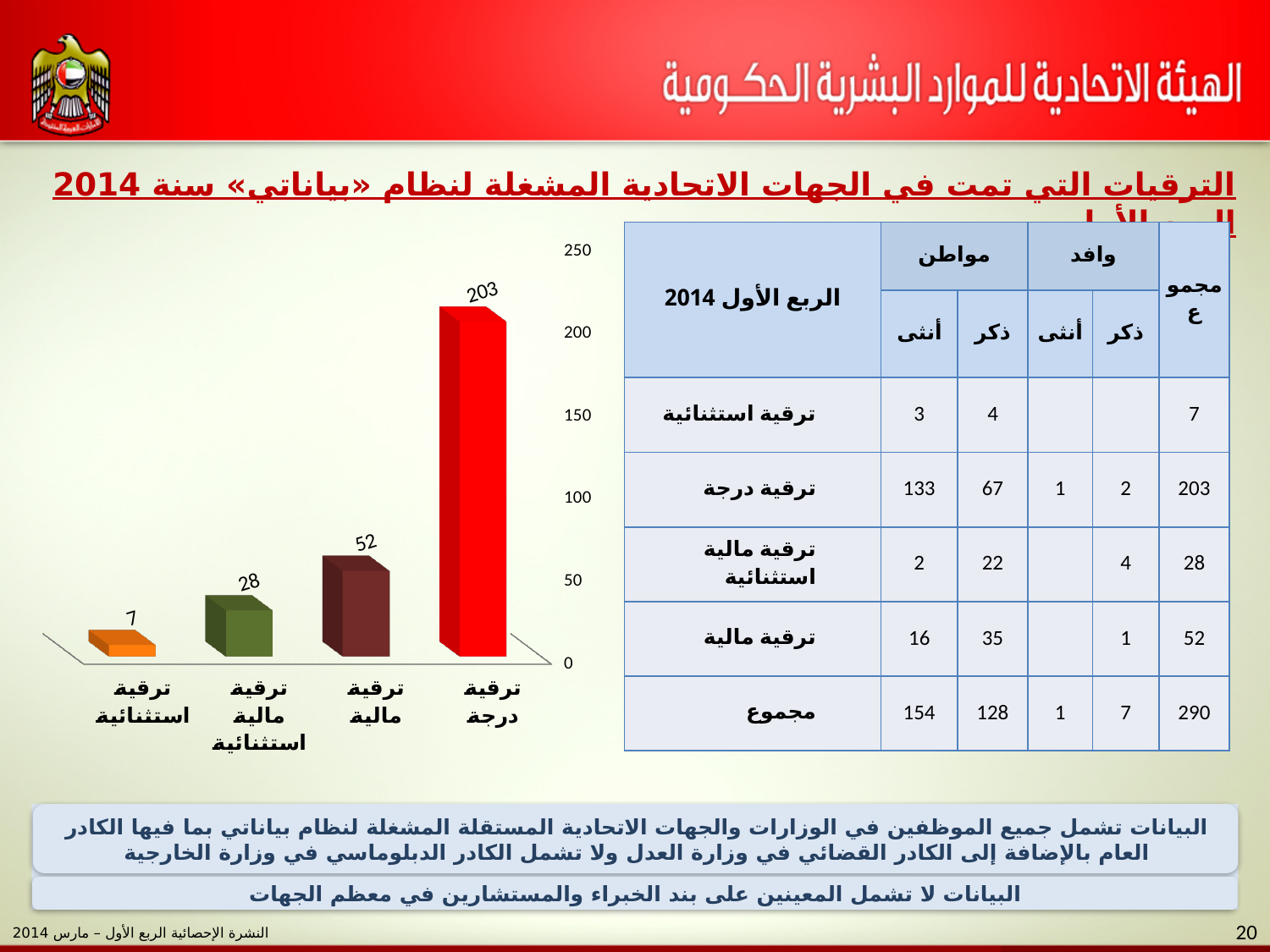
What is the difference between the values for ترقية درجة and ترقية مالية in the bar chart? 151 What is the value for ترقية مالية in the bar chart? 52 What is the value for ترقية استثنائية in the bar chart? 7 Which category has the lowest value in the bar chart? ترقية استثنائية What is the maximum value shown on the vertical axis of the bar chart? 250 How many categories are shown in the bar chart? 4 What is the value for ترقية درجة in the bar chart? 203 What kind of chart is shown on the slide? bar chart What is the value for ترقية مالية استثنائية in the bar chart? 28 Which is larger in the bar chart, ترقية مالية or ترقية مالية استثنائية? ترقية مالية Is the value for ترقية درجة in the bar chart greater or less than 200? greater Which category has the highest value in the bar chart? ترقية درجة